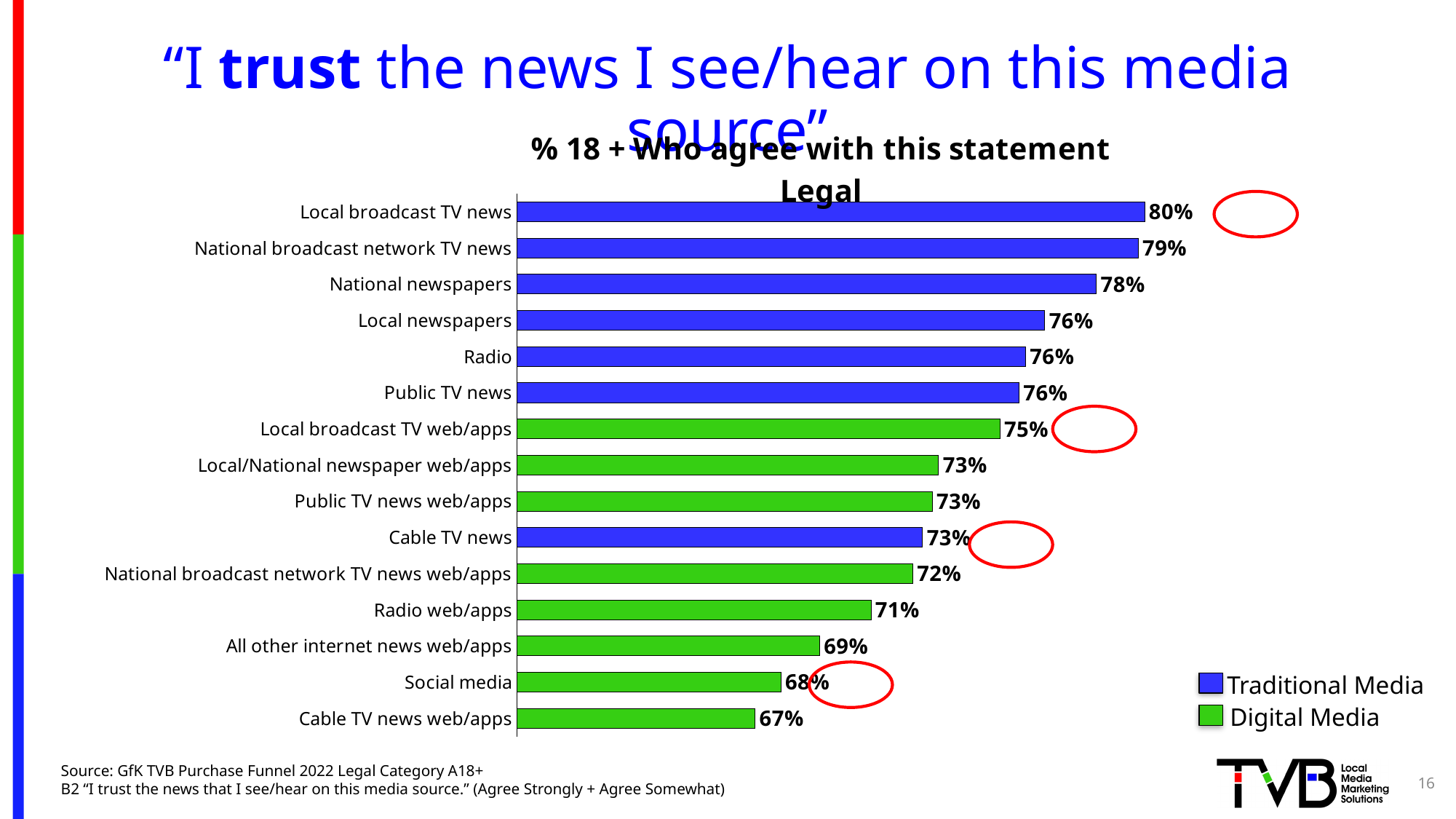
Which legend entry is represented by the green bars? Digital Media What is the difference between the values for Local broadcast TV news and Cable TV news web/apps? 13% What is the value shown for Local broadcast TV web/apps? 75% What kind of chart is shown on the slide? Bar chart How many media sources are shown in the chart? 15 Which has a higher value, Cable TV news or Social media? Cable TV news Which media source has the lowest percentage of agreement? Cable TV news web/apps How many series does the legend list? 2 What is the difference between the values for National newspapers and Radio web/apps? 7% What is the value shown for Social media? 68% Which media source has the highest percentage of agreement? Local broadcast TV news What percentage of adults 18+ agree they trust the news on Local broadcast TV news? 80%